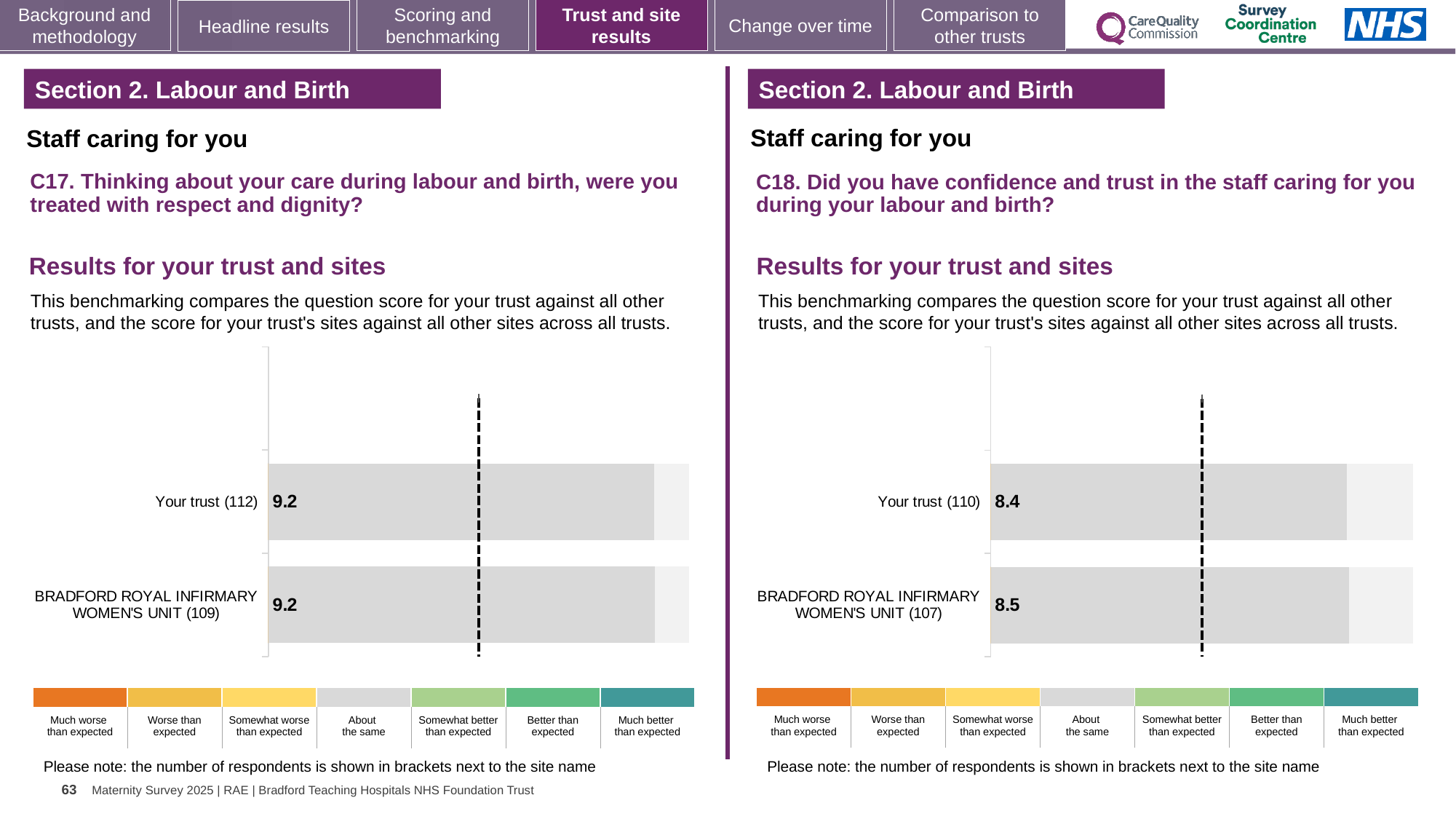
What type of chart is used for the C18 results on the right? Bar chart In the C18 chart on the right, how many respondents are shown in brackets for Bradford Royal Infirmary Women's Unit? 107 In the C17 chart on the left, what is the score for Bradford Royal Infirmary Women's Unit? 9.2 In the C18 chart on the right, which has the higher score: Your trust or Bradford Royal Infirmary Women's Unit? Bradford Royal Infirmary Women's Unit How many bars are plotted in the C17 chart on the left? 2 How many bars are plotted in the C18 chart on the right? 2 In the C17 chart on the left, what is the difference between the score for Your trust and the score for Bradford Royal Infirmary Women's Unit? 0 In the C18 chart on the right, what is the difference between the score for Bradford Royal Infirmary Women's Unit and the score for Your trust? 0.1 In the C17 chart on the left, what is the score for Your trust? 9.2 In the C17 chart on the left, how many respondents are shown in brackets for Your trust? 112 In the C18 chart on the right, what is the score for Bradford Royal Infirmary Women's Unit? 8.5 In the C18 chart on the right, what is the score for Your trust? 8.4